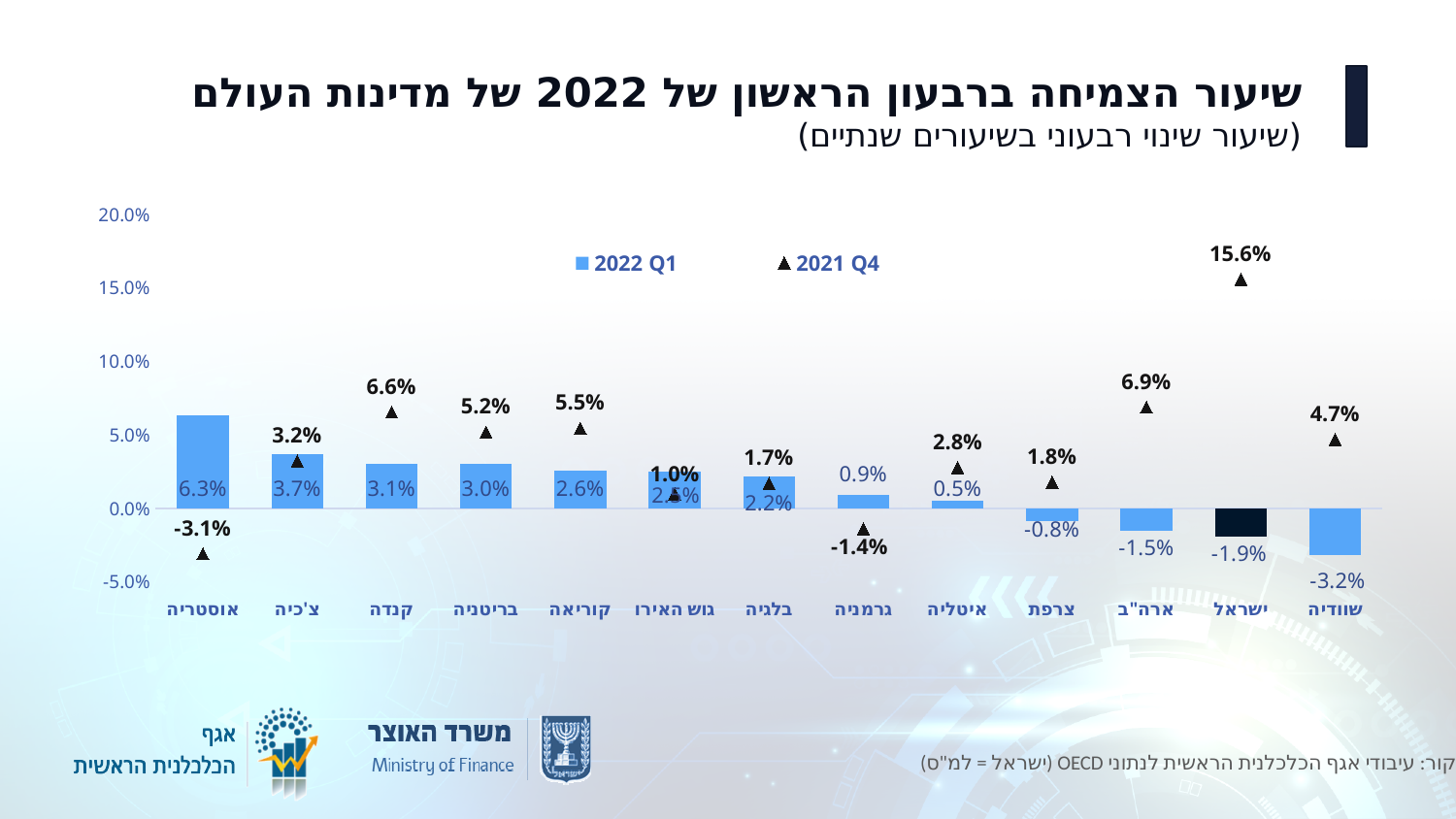
What is the 2021 Q4 value for ישראל (Israel)? 15.6% What is the 2022 Q1 value for אוסטריה (Austria)? 6.3% Which country has the lowest 2021 Q4 value? אוסטריה (Austria) What is the 2021 Q4 value for ארה"ב (USA)? 6.9% Which marker shape represents the 2021 Q4 series in the legend? Triangle What is the 2022 Q1 value for שוודיה (Sweden)? -3.2% What kind of chart is used for the 2022 Q1 series? Bar chart How many series does the legend list? 2 Which country has the highest 2022 Q1 value? אוסטריה (Austria) Which is larger for קנדה (Canada): the 2022 Q1 value or the 2021 Q4 value? 2021 Q4 What is the difference between the 2021 Q4 and 2022 Q1 values for ישראל (Israel)? 17.5 percentage points How many countries/regions are shown on the x axis? 13